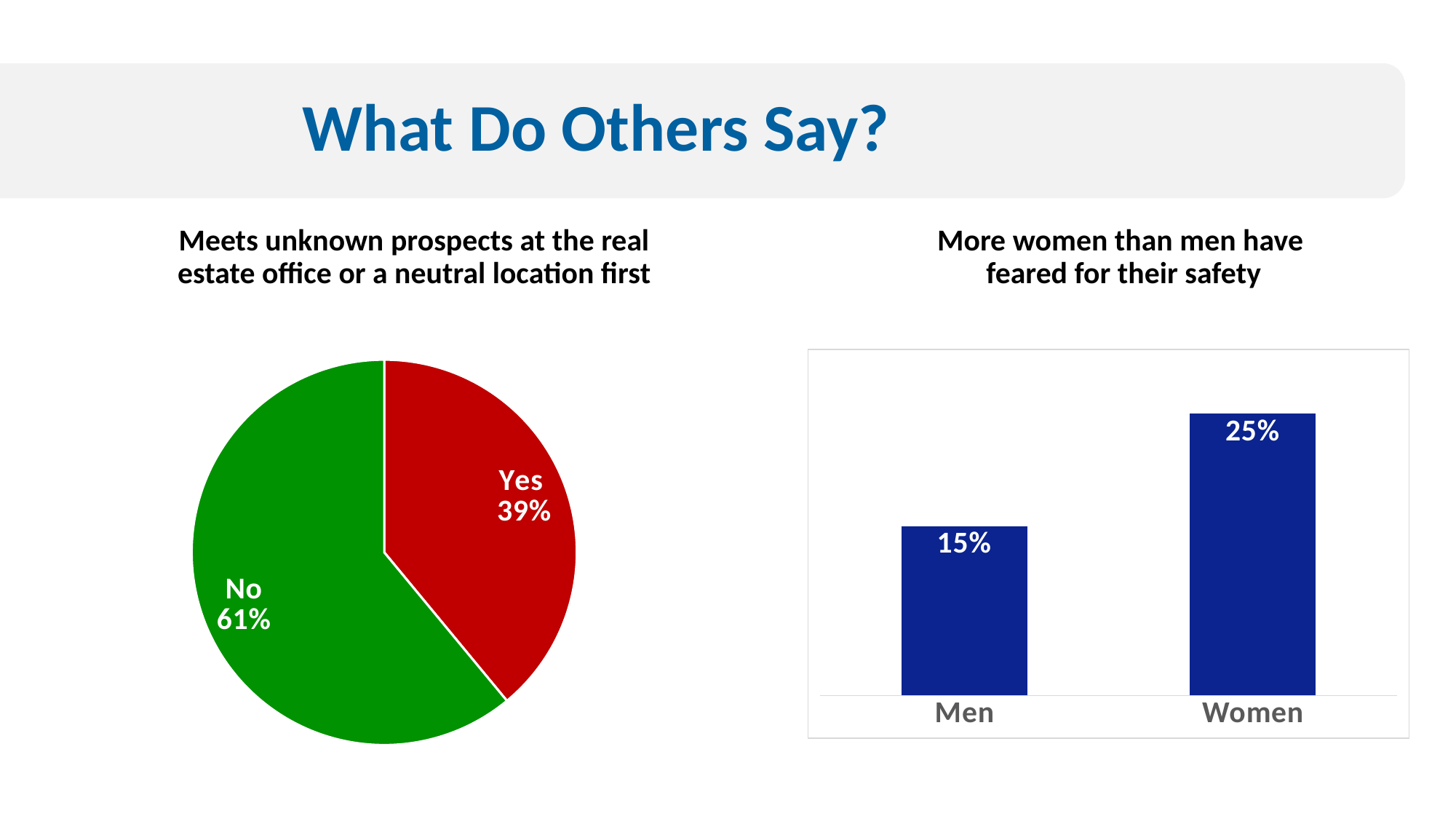
In the chart on the right, what is the value for Men? 15% What type of chart is shown on the right of the slide? Bar chart In the pie chart on the left, what share of respondents answered No? 61% In the chart on the right, what is the value for Women? 25% In the pie chart on the left, what colour is the No slice? Green In the pie chart on the left, what share of respondents answered Yes? 39% What type of chart is shown on the left of the slide? Pie chart How many slices does the pie chart on the left have? 2 In the chart on the right, which category has the higher value? Women In the chart on the right, what is the difference between the values for Women and Men? 10% In the pie chart on the left, what is the difference between the No and Yes shares? 22% In the pie chart on the left, which slice is larger, Yes or No? No